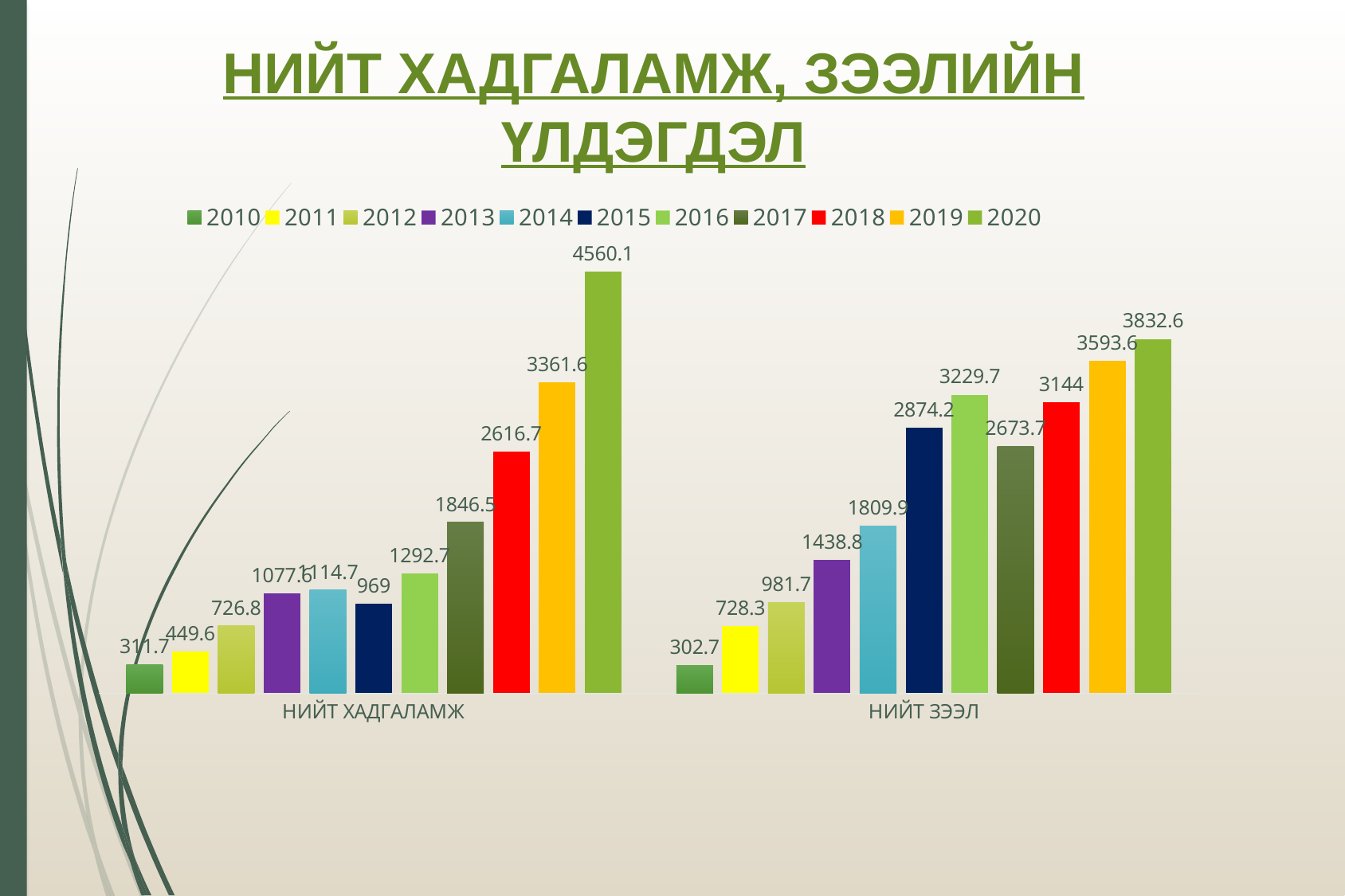
How many categories are shown on the x axis? 2 Which year has the lowest value in the НИЙТ ХАДГАЛАМЖ category? 2010 What is the value for 2010 in the НИЙТ ЗЭЭЛ category? 302.7 What is the value for 2015 in the НИЙТ ЗЭЭЛ category? 2874.2 How many series does the legend list? 11 What colour are the bars for 2018? Red Which is larger: the 2017 value for НИЙТ ХАДГАЛАМЖ or the 2017 value for НИЙТ ЗЭЭЛ? НИЙТ ЗЭЭЛ What is the value for 2020 in the НИЙТ ХАДГАЛАМЖ category? 4560.1 What is the value for 2018 in the НИЙТ ХАДГАЛАМЖ category? 2616.7 What is the difference between the 2020 values for НИЙТ ХАДГАЛАМЖ and НИЙТ ЗЭЭЛ? 727.5 Which year has the highest value in the НИЙТ ЗЭЭЛ category? 2020 What kind of chart is shown on the slide? Bar chart